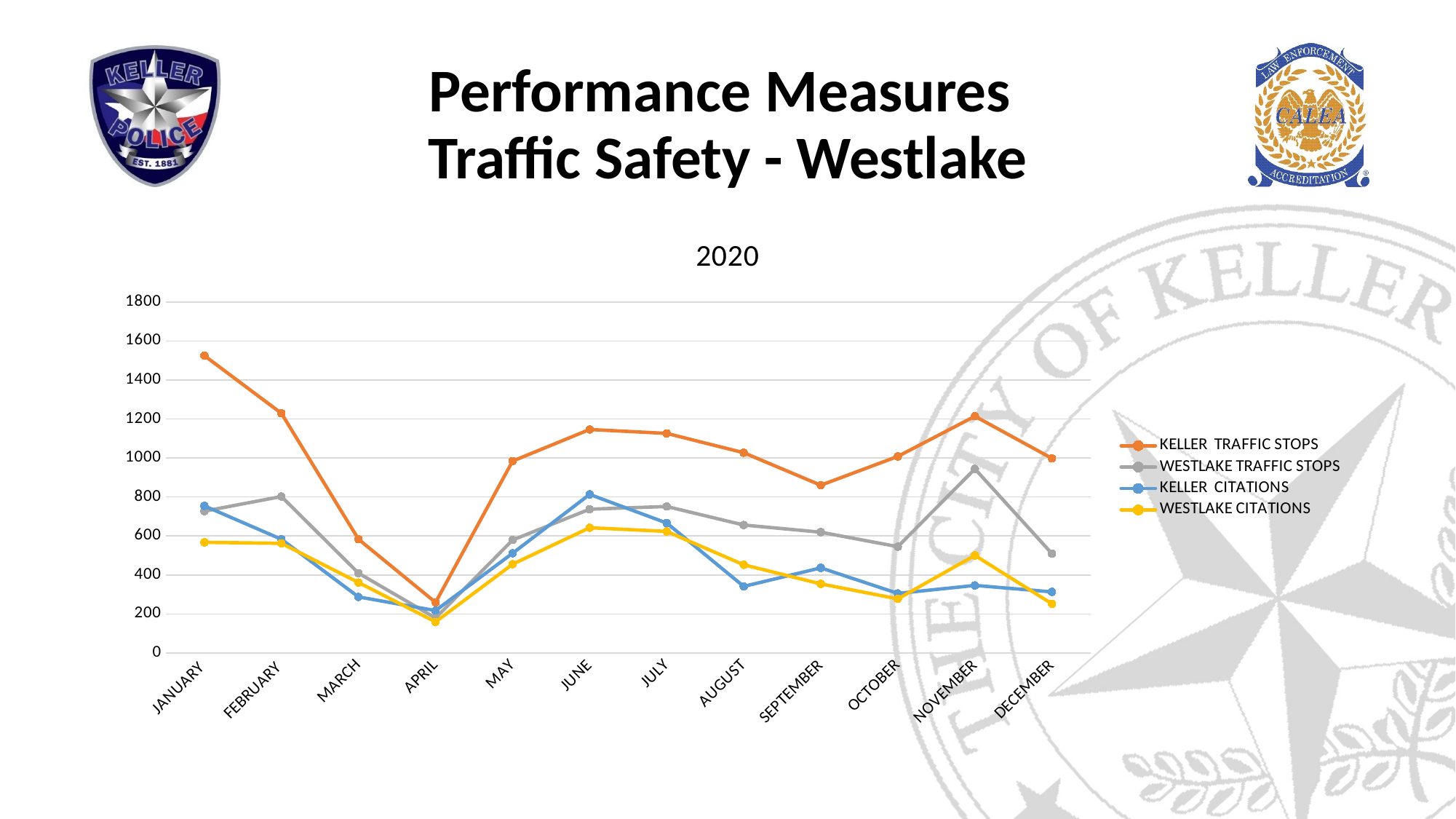
In which month is WESTLAKE TRAFFIC STOPS highest? NOVEMBER Is the value for KELLER TRAFFIC STOPS in JANUARY greater or less than 1400? greater Do the values for KELLER TRAFFIC STOPS rise or fall from JANUARY to APRIL? fall Is the value for KELLER CITATIONS in AUGUST greater or less than 400? less How many series does the legend list? 4 What is the title of the chart? 2020 In NOVEMBER, which is larger: WESTLAKE TRAFFIC STOPS or KELLER CITATIONS? WESTLAKE TRAFFIC STOPS Which series is drawn in orange? KELLER TRAFFIC STOPS How many months are plotted along the x axis? 12 In which month is KELLER TRAFFIC STOPS highest? JANUARY What kind of chart is shown on the slide? line chart In which month is KELLER TRAFFIC STOPS lowest? APRIL